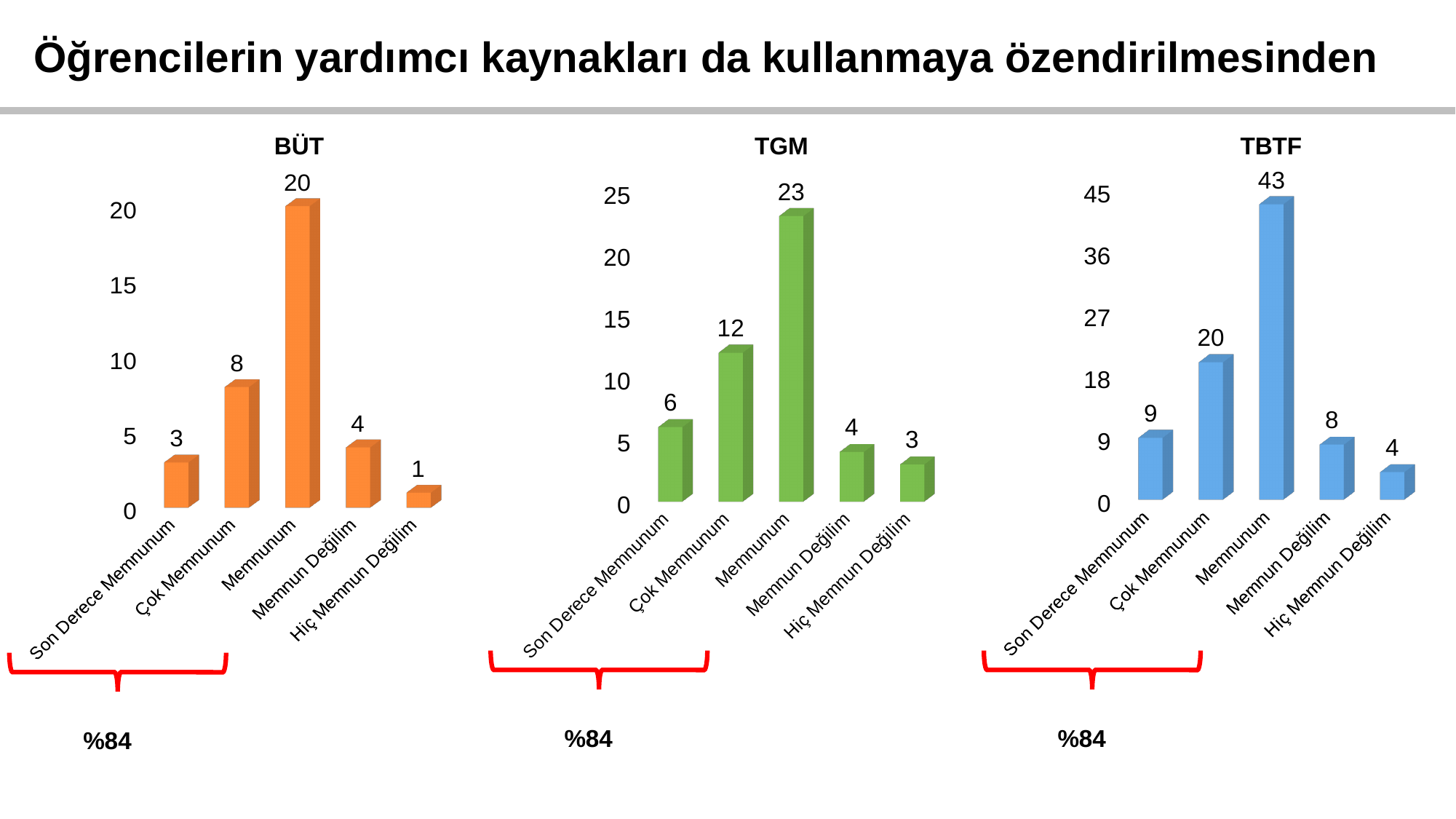
In the TBTF chart, what is the difference between Memnunum and Çok Memnunum? 23 In the BÜT chart, what is the value for Memnunum? 20 In the TGM chart, what is the value for Hiç Memnun Değilim? 3 In the TGM chart, how many categories are shown? 5 In the TGM chart, what is the difference between Memnunum and Çok Memnunum? 11 What colour are the bars in the TGM chart? Green In the TBTF chart, which category has the highest value? Memnunum In the TBTF chart, what is the value for Son Derece Memnunum? 9 In the BÜT chart, which is larger: Çok Memnunum or Memnun Değilim? Çok Memnunum In the TGM chart, what is the value for Çok Memnunum? 12 In the BÜT chart, which category has the lowest value? Hiç Memnun Değilim What kind of chart is the TBTF chart? Bar chart